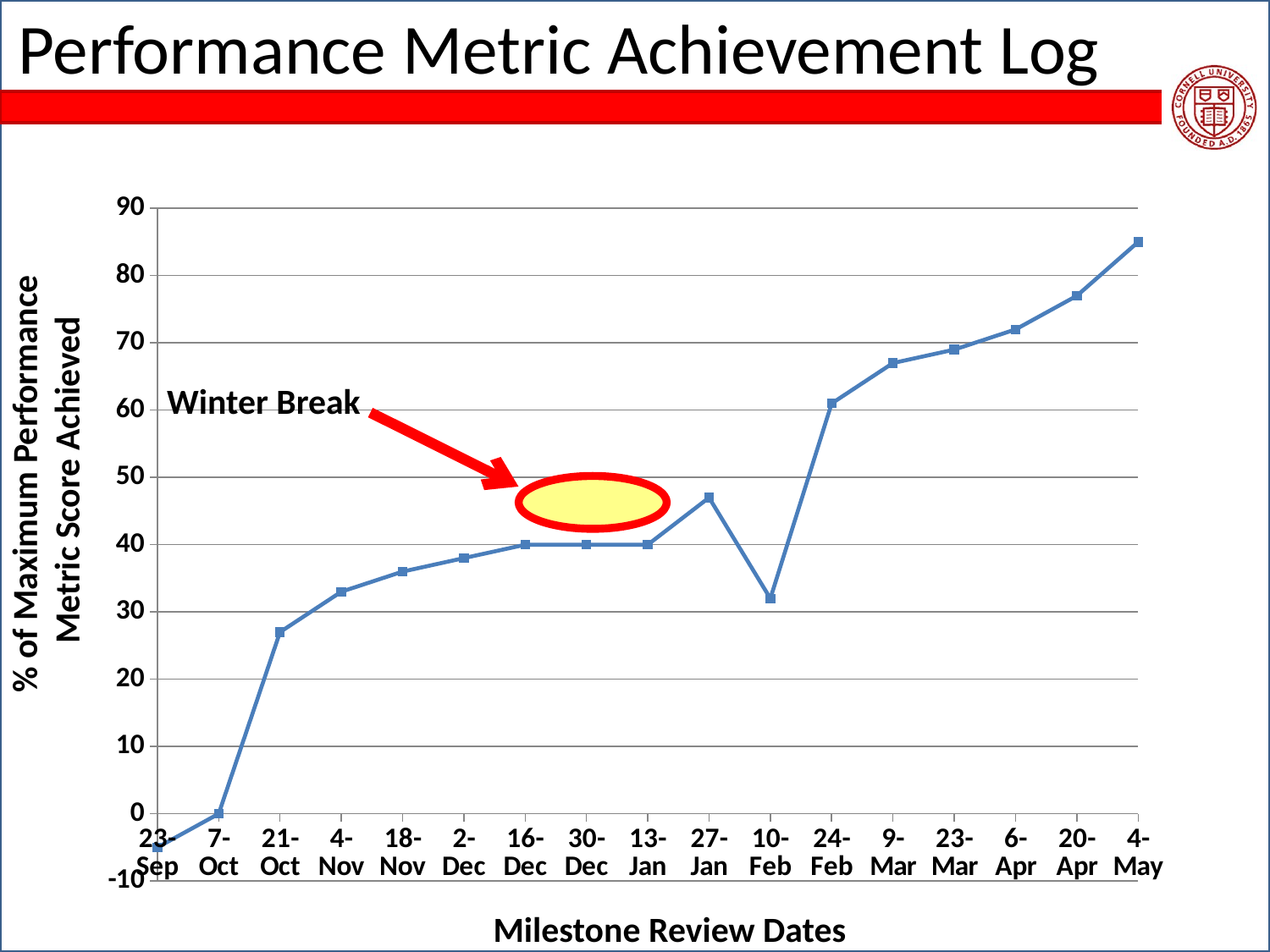
What is the value for 16-Dec? 40 Which milestone review date has the lowest value? 23-Sep Is the value for 4-May greater or less than 80? greater Is the value for 10-Feb greater or less than 40? less What kind of chart is shown on the slide? line chart Overall, do the values rise or fall from 23-Sep to 4-May? rise What does the red arrow annotation on the chart label? Winter Break What is the value for 7-Oct? 0 Which is larger, the value for 27-Jan or the value for 10-Feb? 27-Jan Is the value for 20-Apr greater or less than 70? greater Which milestone review date has the highest value? 4-May How many milestone review dates are plotted on the x axis? 17